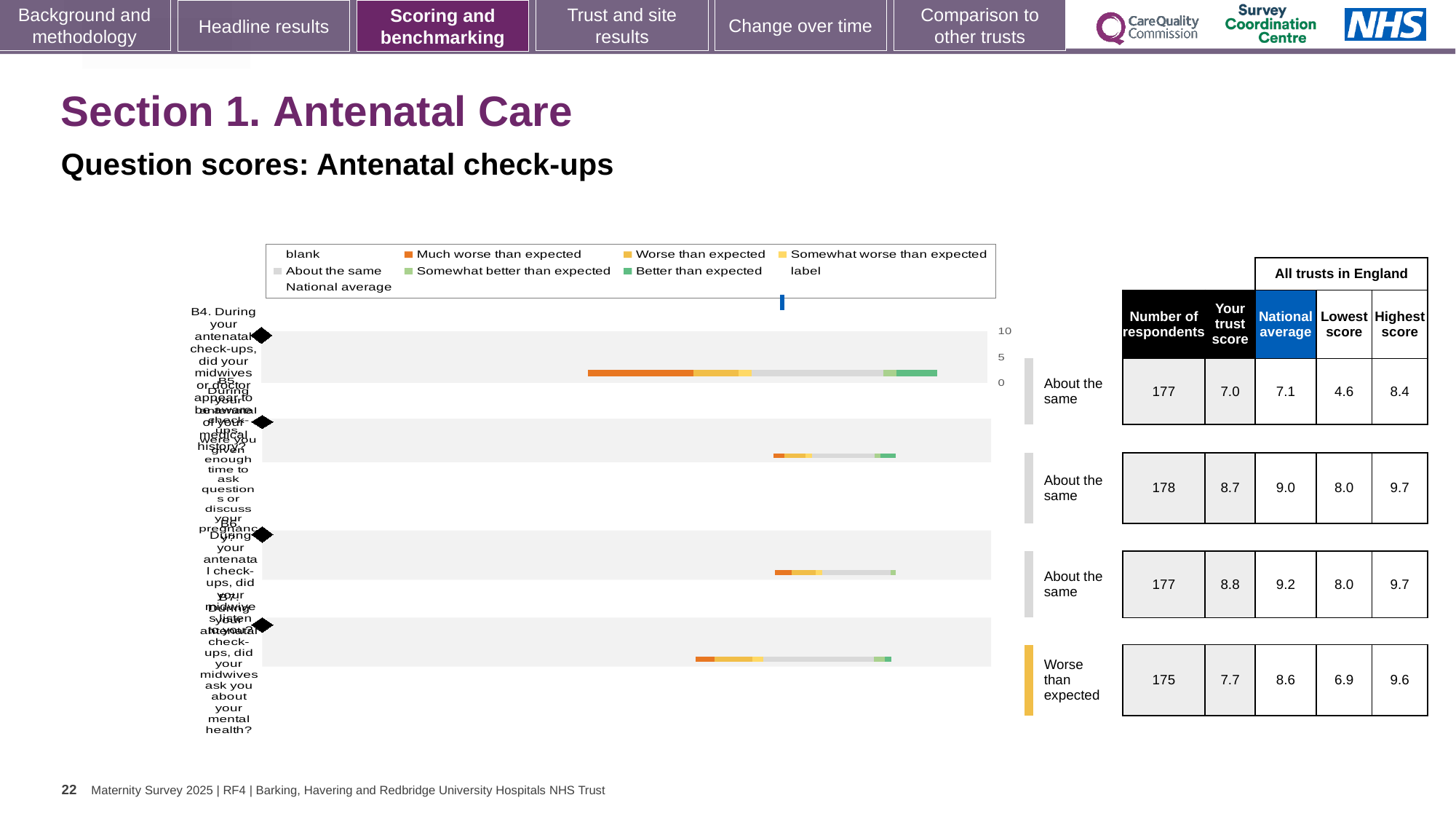
Which legend entry is shown in orange? Much worse than expected What is the highest 'Your trust score' value shown in the table? 8.8 What is the national average for the last question (B7, about mental health)? 8.6 What is the difference between the highest score and the lowest score for the first question (B4)? 3.8 What is the 'Your trust score' for the first question (B4, awareness of medical history)? 7.0 Which question is rated 'Worse than expected'? B7, about mental health What is the lowest score across all trusts for the mental health question (B7)? 6.9 How many questions (bars) are plotted in the chart? 4 What type of chart is used to show the question scores on this slide? bar chart What is the smallest number of respondents shown for any question? 175 How many respondents answered the first question (B4)? 177 Is the trust score for the first question (B4) higher or lower than the national average? lower